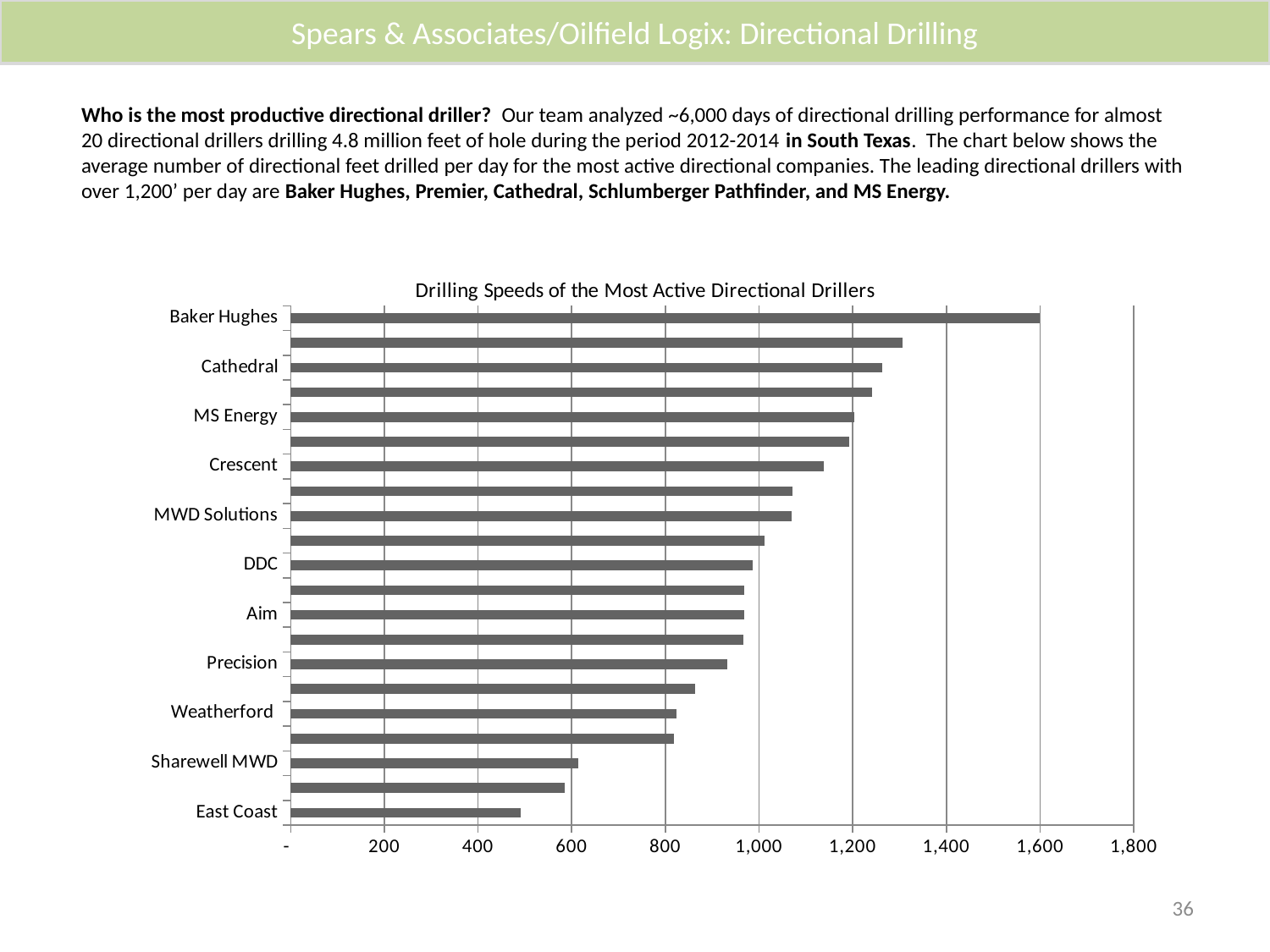
Which has a higher drilling speed, Weatherford or Crescent? Crescent Is the value for Baker Hughes greater or less than 1,400? greater Is the value for Crescent greater or less than 1,200? less Which has a higher drilling speed, Baker Hughes or Cathedral? Baker Hughes Is the value for East Coast greater or less than 600? less Do the bar lengths increase or decrease going from the top of the chart to the bottom? decrease Which directional driller has the highest drilling speed in the chart? Baker Hughes Which directional driller has the lowest drilling speed in the chart? East Coast What is the title of the chart? Drilling Speeds of the Most Active Directional Drillers What type of chart is shown on the slide? bar chart